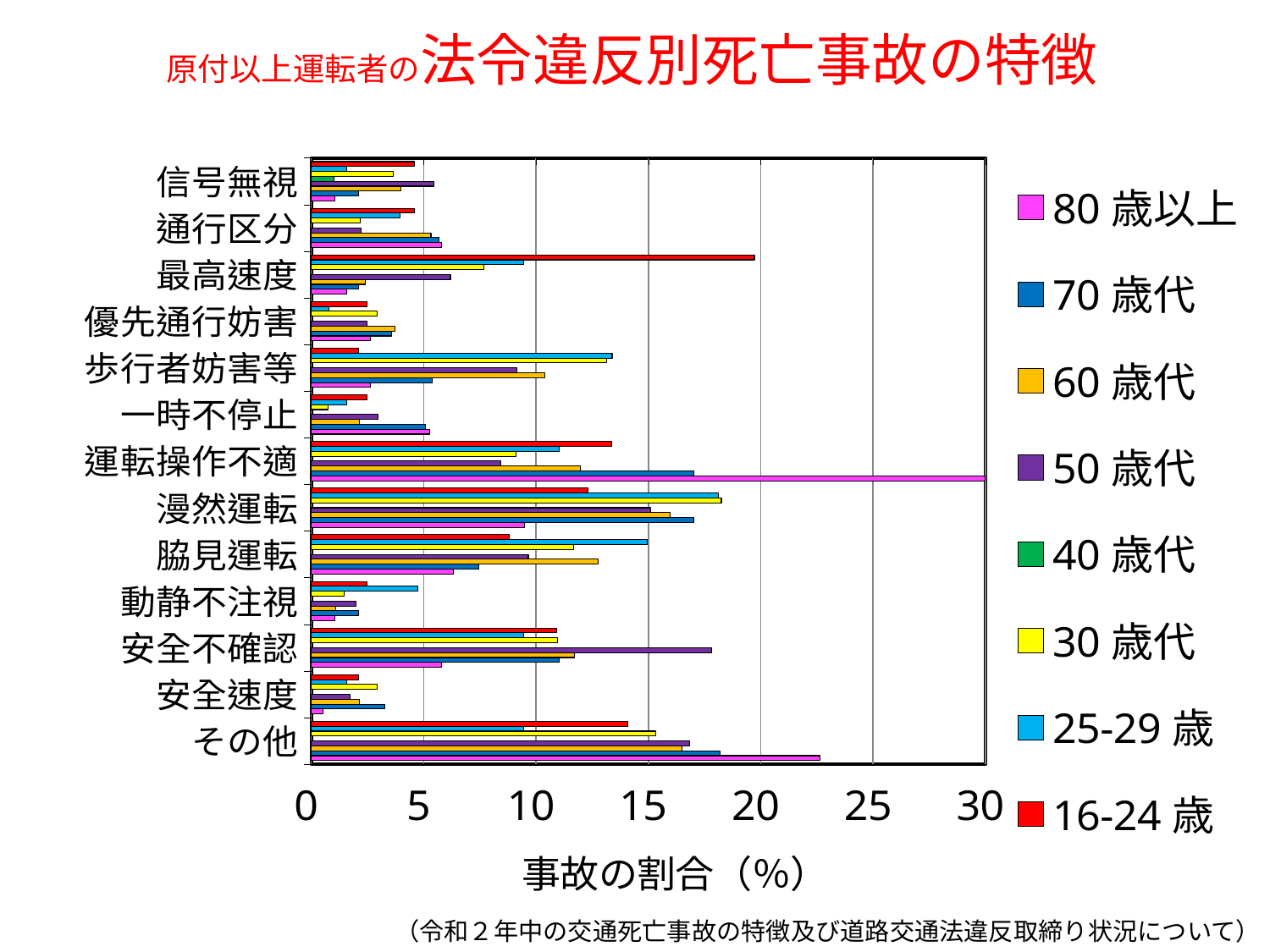
Is the value for その他 in the 80 歳以上 series greater or less than 20? greater What kind of chart is shown on the slide? bar chart How many age-group series does the legend list? 8 Is the value for 安全不確認 in the 50 歳代 series greater or less than 15? greater Which age-group series has the highest value for 最高速度? 16-24 歳 What is the label of the horizontal axis of the chart? 事故の割合（%） Is the value for 動静不注視 in the 80 歳以上 series greater or less than 5? less For 運転操作不適, which is larger: the value for 80 歳以上 or the value for 16-24 歳? 80 歳以上 Which category has the highest value in the 80 歳以上 series? 運転操作不適 How many violation categories are listed on the vertical axis of the chart? 13